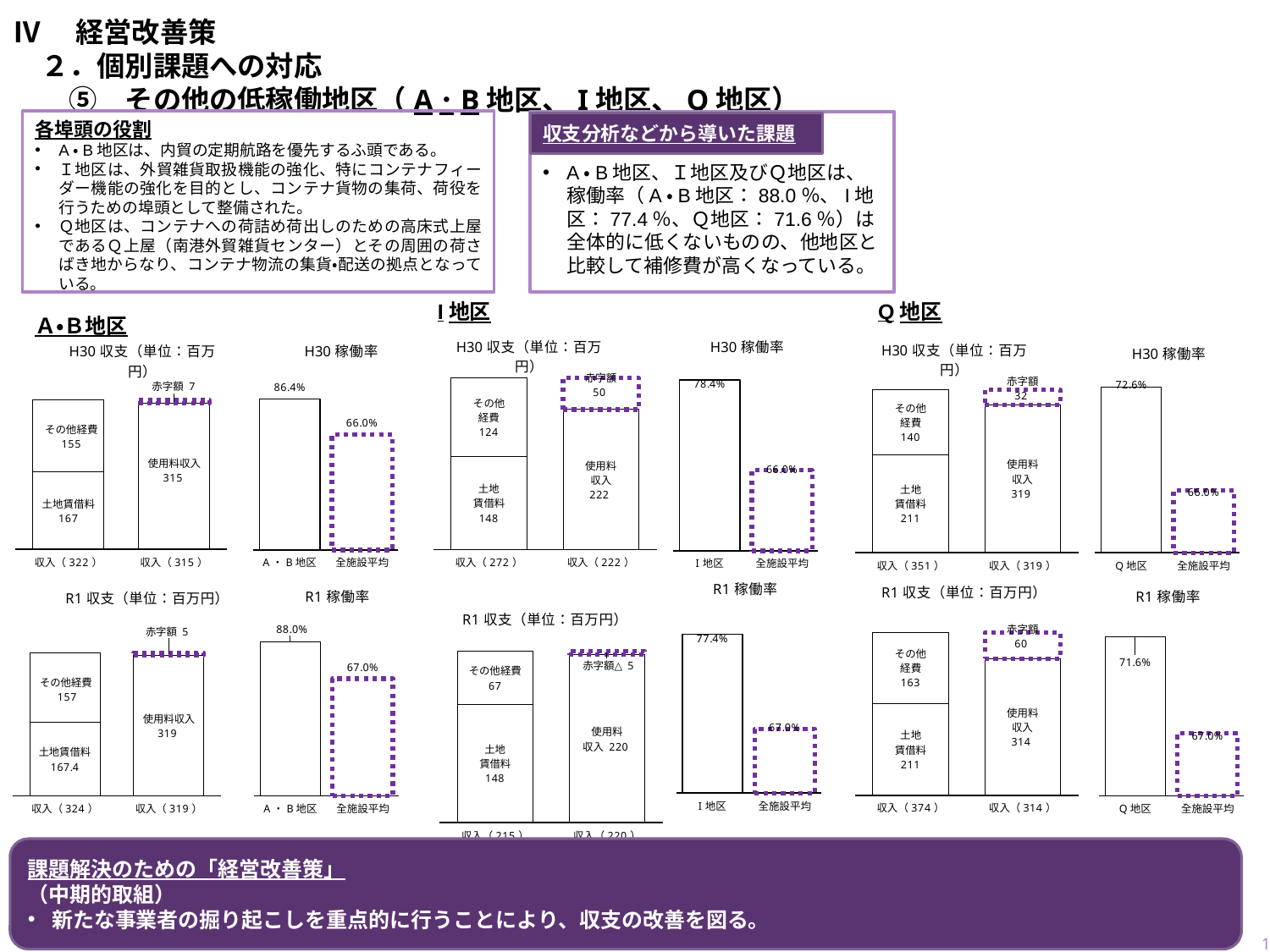
A・B地区の「R1 稼働率」グラフで、全施設平均の値はいくらですか？ 67.0% Q地区の「R1 収支」グラフで、使用料収入はいくらですか？ 314 A・B地区の「R1 収支」グラフで、土地賃借料の値はいくらですか？ 167.4 Q地区の「H30 稼働率」グラフで、Q地区の稼働率はいくらですか？ 72.6% A・B地区の「H30 稼働率」グラフはどの種類のグラフですか？ 棒グラフ I地区の「H30 収支」グラフで、その他経費と土地賃借料を合計した収入はいくらですか？ 272 I地区の「H30 収支」グラフで、赤字額はいくらですか？ 50 Q地区の「R1 収支」グラフで、赤字額はいくらですか？ 60 A・B地区の「H30 稼働率」グラフで、A・B地区の稼働率はいくらですか？ 86.4% Q地区の「H30 収支」グラフで、その他経費と土地賃借料ではどちらが大きいですか？ 土地賃借料 I地区の「R1 稼働率」グラフで、I地区と全施設平均の差はいくらですか？ 10.4% I地区の「R1 稼働率」グラフで、I地区と全施設平均ではどちらが高いですか？ I地区